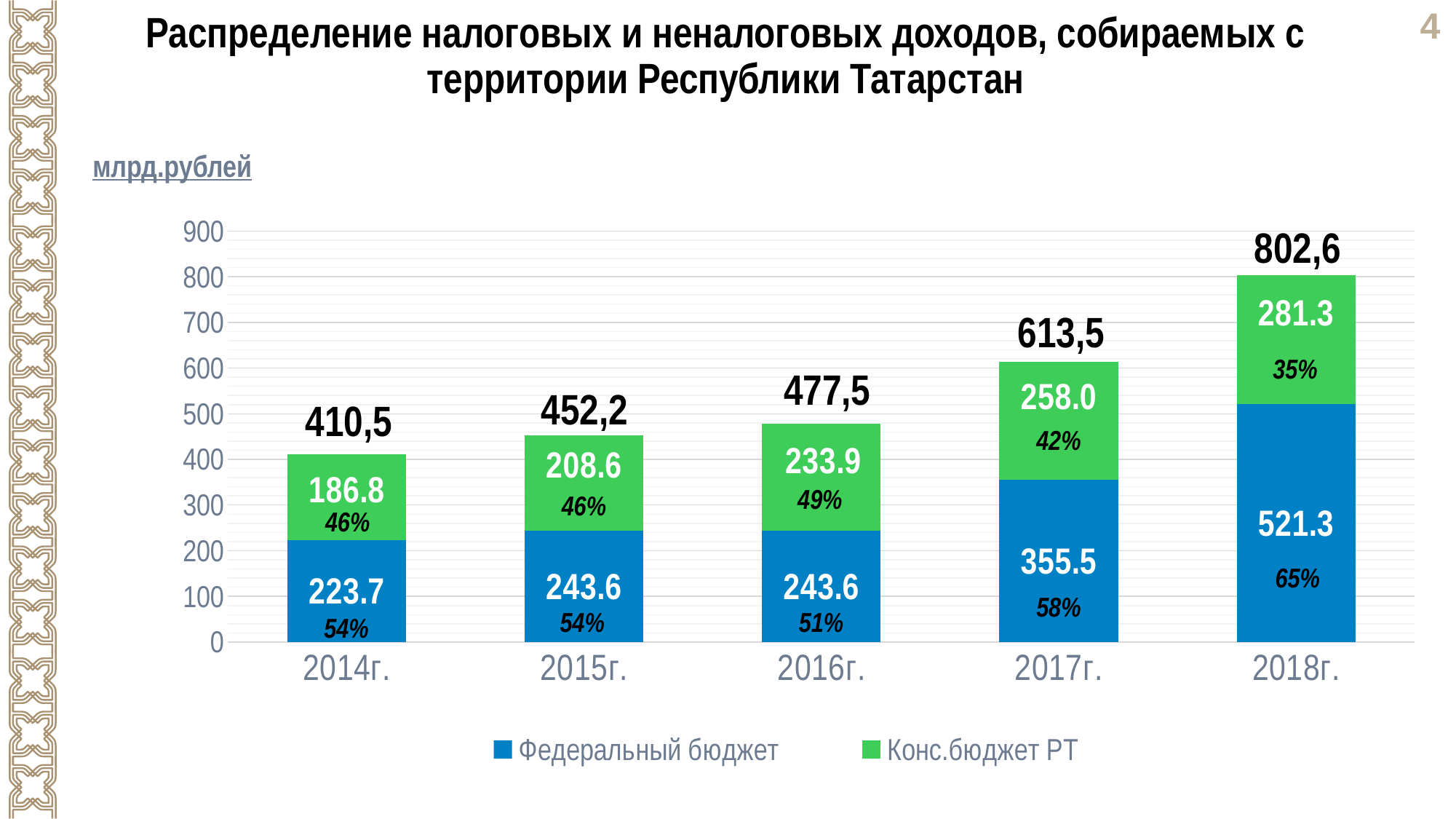
Which is larger in 2014г.: Федеральный бюджет or Конс.бюджет РТ? Федеральный бюджет How many series does the legend list? 2 What percentage share is shown for Конс.бюджет РТ in 2016г.? 49% What is the value for Федеральный бюджет in 2017г.? 355.5 Which year has the highest total? 2018г. What is the value for Конс.бюджет РТ in 2015г.? 208.6 What total is printed above the bar for 2018г.? 802,6 What kind of chart is shown on the slide? Stacked bar chart How many years are shown on the x axis? 5 Which year has the lowest value for Федеральный бюджет? 2014г. What is the difference between the Федеральный бюджет values for 2018г. and 2017г.? 165.8 Do the totals rise or fall from 2014г. to 2018г.? Rise